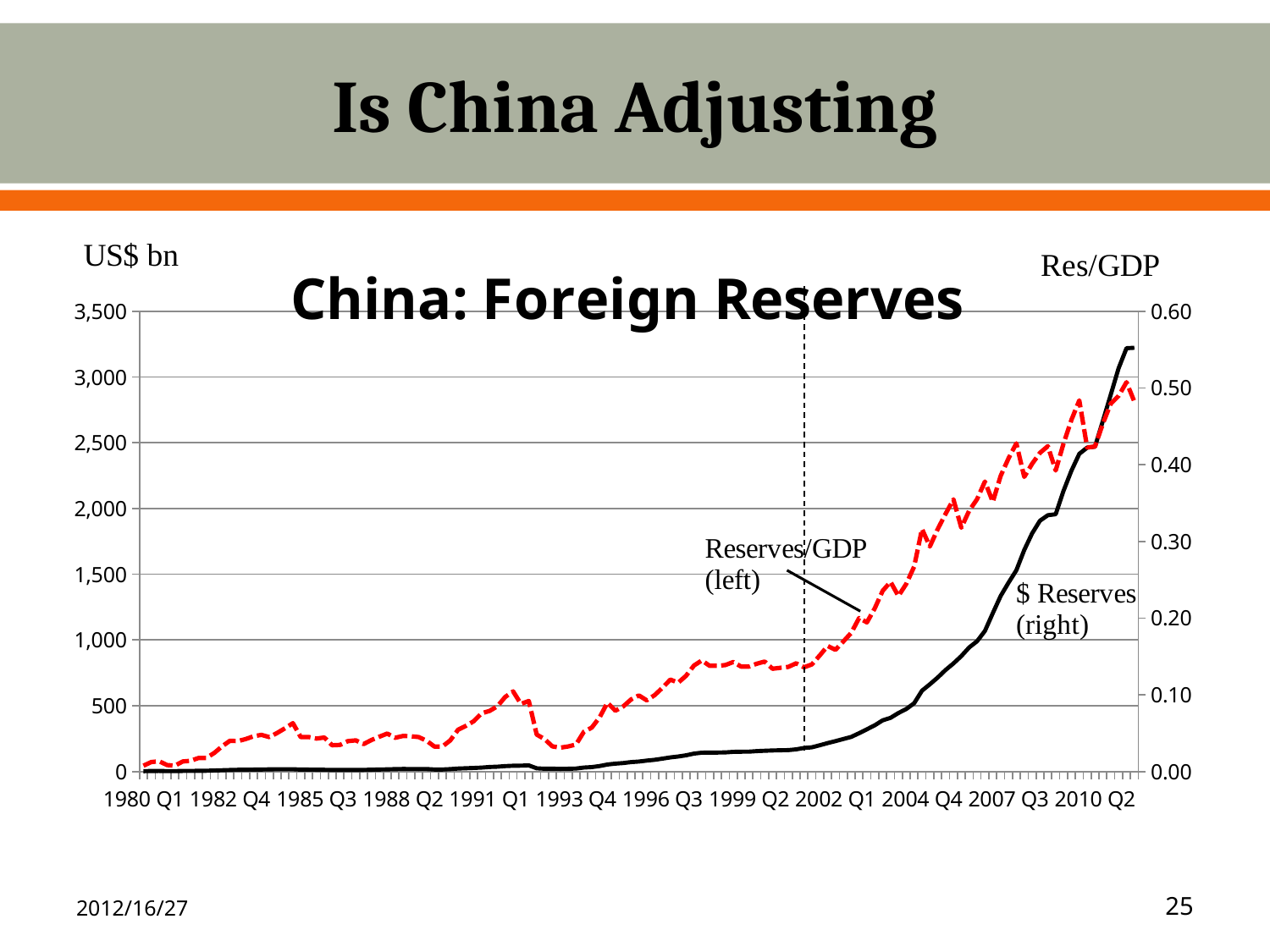
Does the $ Reserves line rise or fall from 1980 Q1 to the end of the series? rise What kind of chart is shown on the slide? line chart How many series are plotted on the chart? 2 Is the value of Reserves/GDP at 1980 Q1 greater or less than 0.10? less Is the value of $ Reserves at 2010 Q2 greater or less than 2,000? greater What is the title of the chart? China: Foreign Reserves Is the value of $ Reserves at 1996 Q3 greater or less than 500? less Which series is drawn as a dashed line? Reserves/GDP How many date labels are shown along the x axis? 12